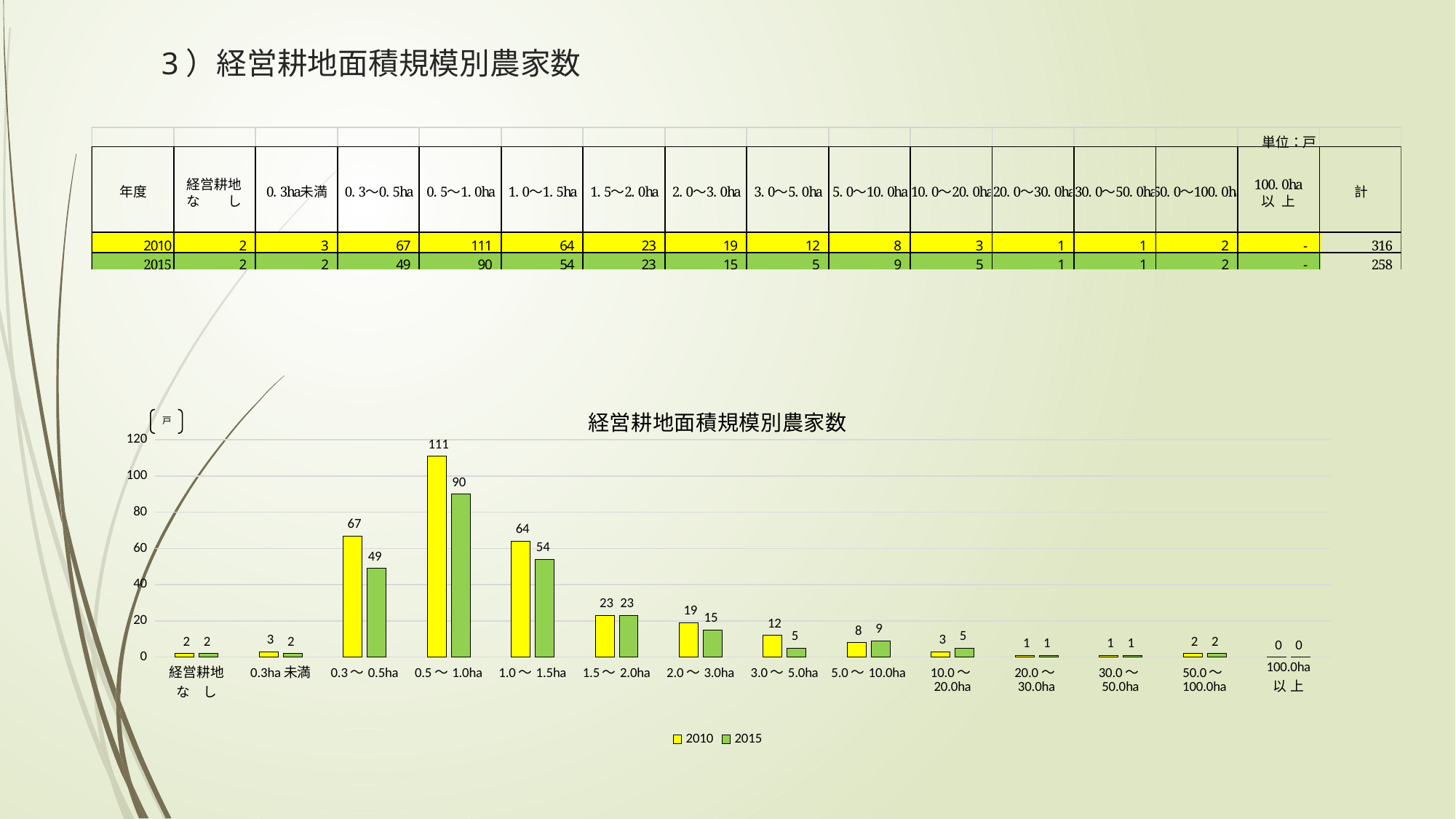
What is the difference between the 2010 and 2015 values in the 1.0～1.5ha category? 10 What is the value for 2010 in the 0.5～1.0ha category? 111 Which category has the highest value for the 2010 series? 0.5～1.0ha What is the value for 2015 in the 0.3～0.5ha category? 49 What is the title of the chart? 経営耕地面積規模別農家数 What kind of chart is shown on the slide? Bar chart How many series does the legend list? 2 What is the value for 2015 in the 3.0～5.0ha category? 5 In the 2.0～3.0ha category, which series has the larger value, 2010 or 2015? 2010 What is the difference between the 2010 and 2015 values in the 0.5～1.0ha category? 21 In the 5.0～10.0ha category, which series has the larger value, 2010 or 2015? 2015 How many categories are shown on the x axis of the chart? 14